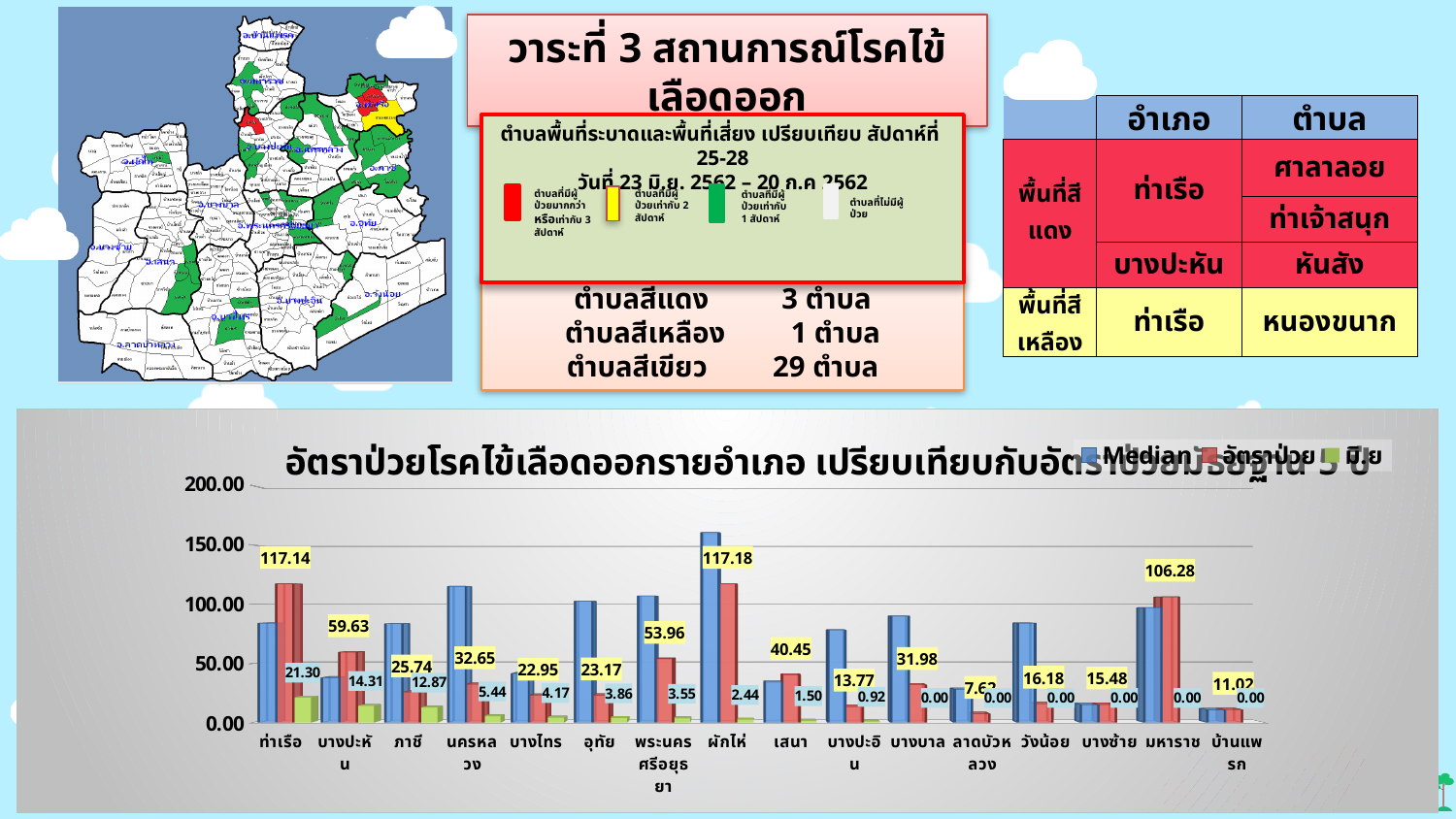
What is the มิ.ย value for บางปะหัน? 14.31 How many series does the chart legend list? 3 Which is larger, the อัตราป่วย value for บางปะหัน or for เสนา? บางปะหัน What is the อัตราป่วย value for ท่าเรือ? 117.14 How many districts are shown on the x axis of the chart? 16 Is the Median value for บางซ้าย greater or less than 50.00? less What is the อัตราป่วย value for มหาราช? 106.28 Is the Median value for ผักไห่ greater or less than 150.00? greater What is the difference between the อัตราป่วย values for มหาราช and บ้านแพรก? 95.26 What kind of chart is shown at the bottom of the slide? bar chart Which district has the lowest อัตราป่วย value? ลาดบัวหลวง Which district has the highest มิ.ย value? ท่าเรือ